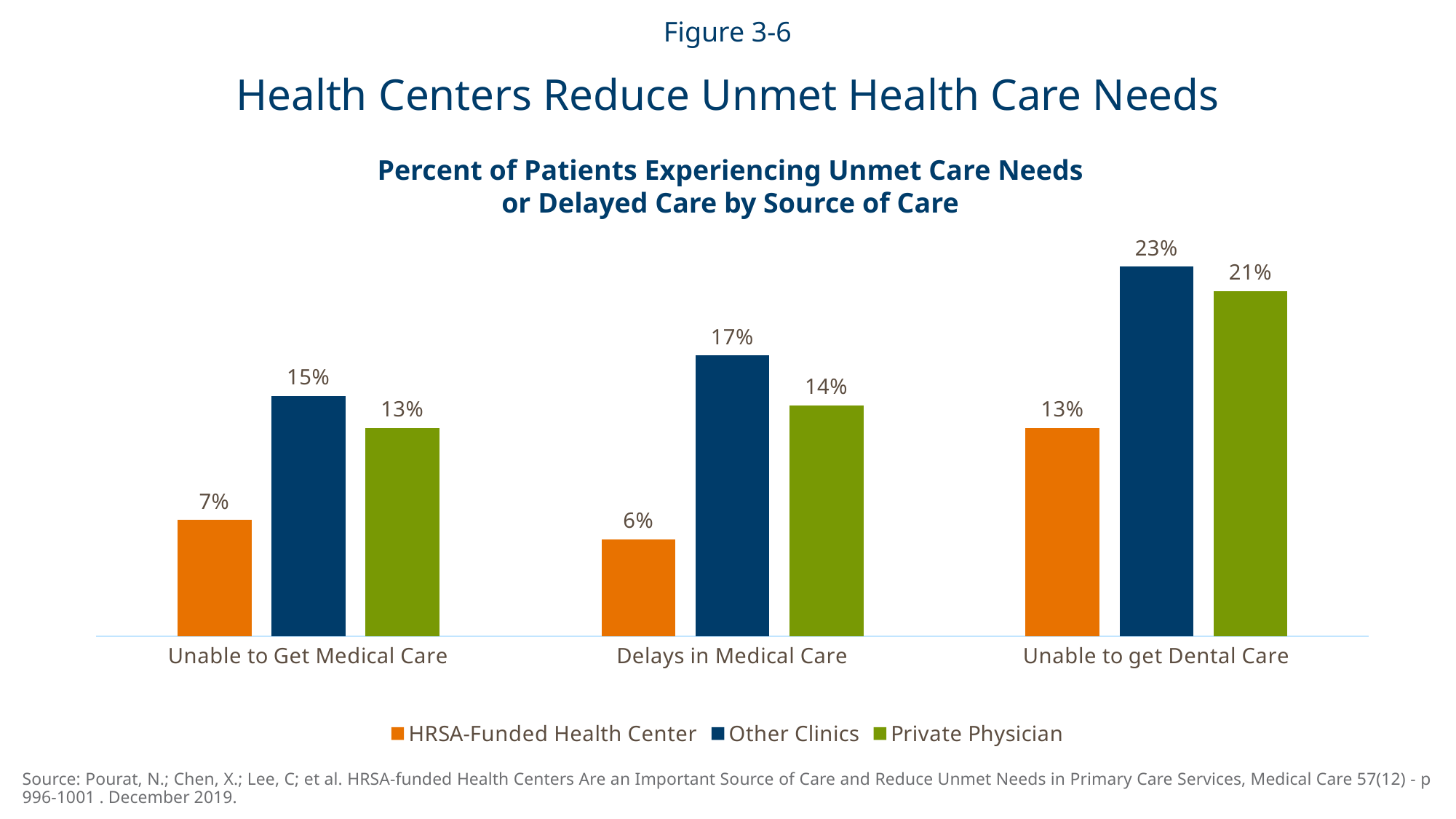
What kind of chart is shown on the slide? Bar chart How many categories are shown on the x axis? 3 What percent of HRSA-Funded Health Center patients were unable to get medical care? 7% What is the difference between Other Clinics and HRSA-Funded Health Center for Unable to Get Medical Care? 8% What is the difference between Private Physician and HRSA-Funded Health Center for Unable to get Dental Care? 8% Which source of care has the lowest value for Delays in Medical Care? HRSA-Funded Health Center What is the value for Other Clinics in the Delays in Medical Care category? 17% What percent of Private Physician patients were unable to get dental care? 21% How many series does the legend list? 3 Which colour represents Other Clinics in the chart? Dark blue Which source of care has the highest value for Unable to get Dental Care? Other Clinics Which is larger: Private Physician for Delays in Medical Care or Private Physician for Unable to Get Medical Care? Delays in Medical Care